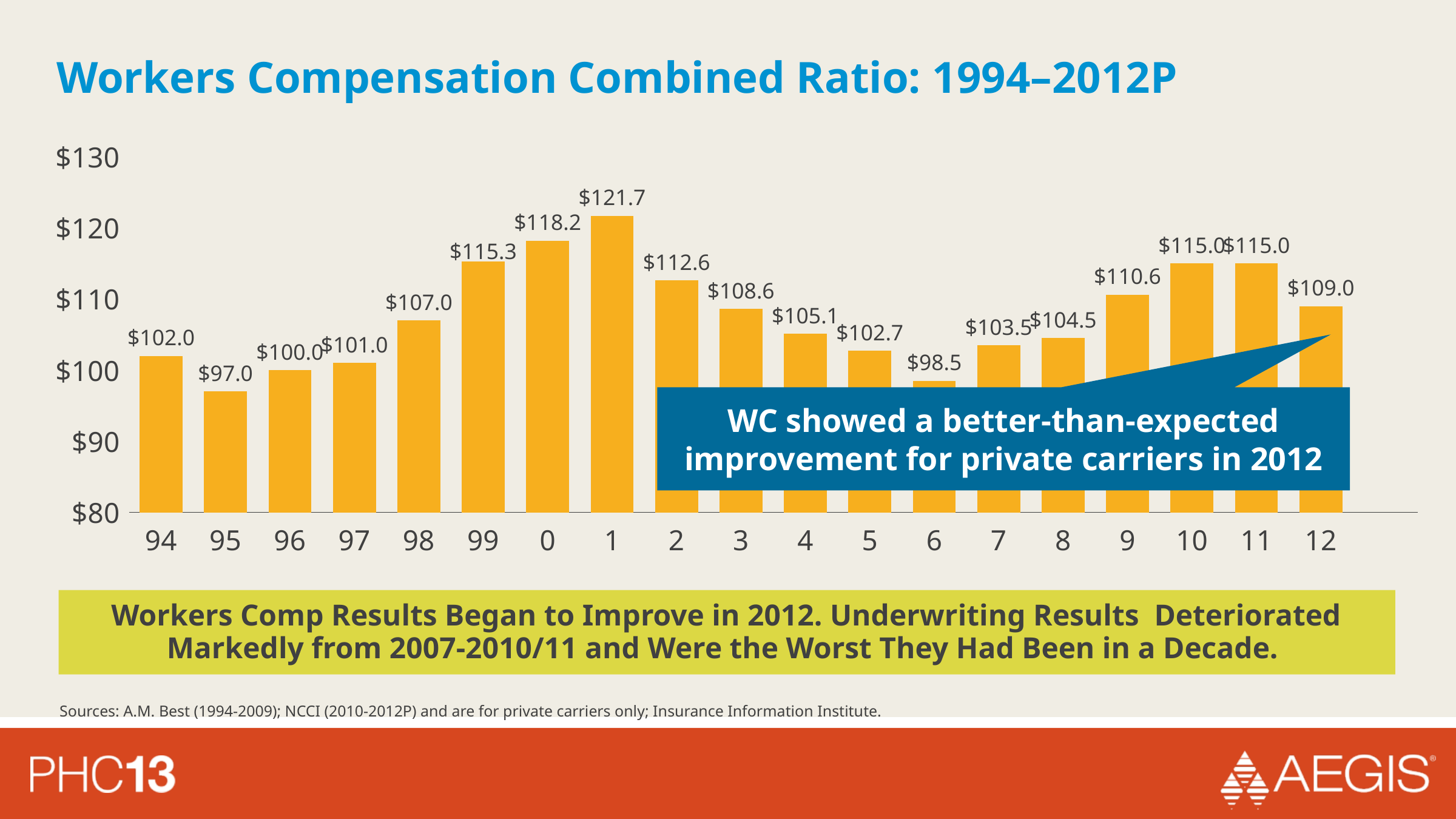
Do the values rise or fall from 96 to 1? rise What is the value for 1? $121.7 What is the difference between the values for 1 and 2? $9.1 What kind of chart is shown on the slide? bar chart What is the value for 94? $102.0 Which category has the lowest value? 95 Which category has the highest value? 1 How many categories are shown on the x axis? 19 What is the title of the chart? Workers Compensation Combined Ratio: 1994–2012P Which is larger, the value for 9 or the value for 12? 9 What is the value for 12? $109.0 What is the value for 6? $98.5